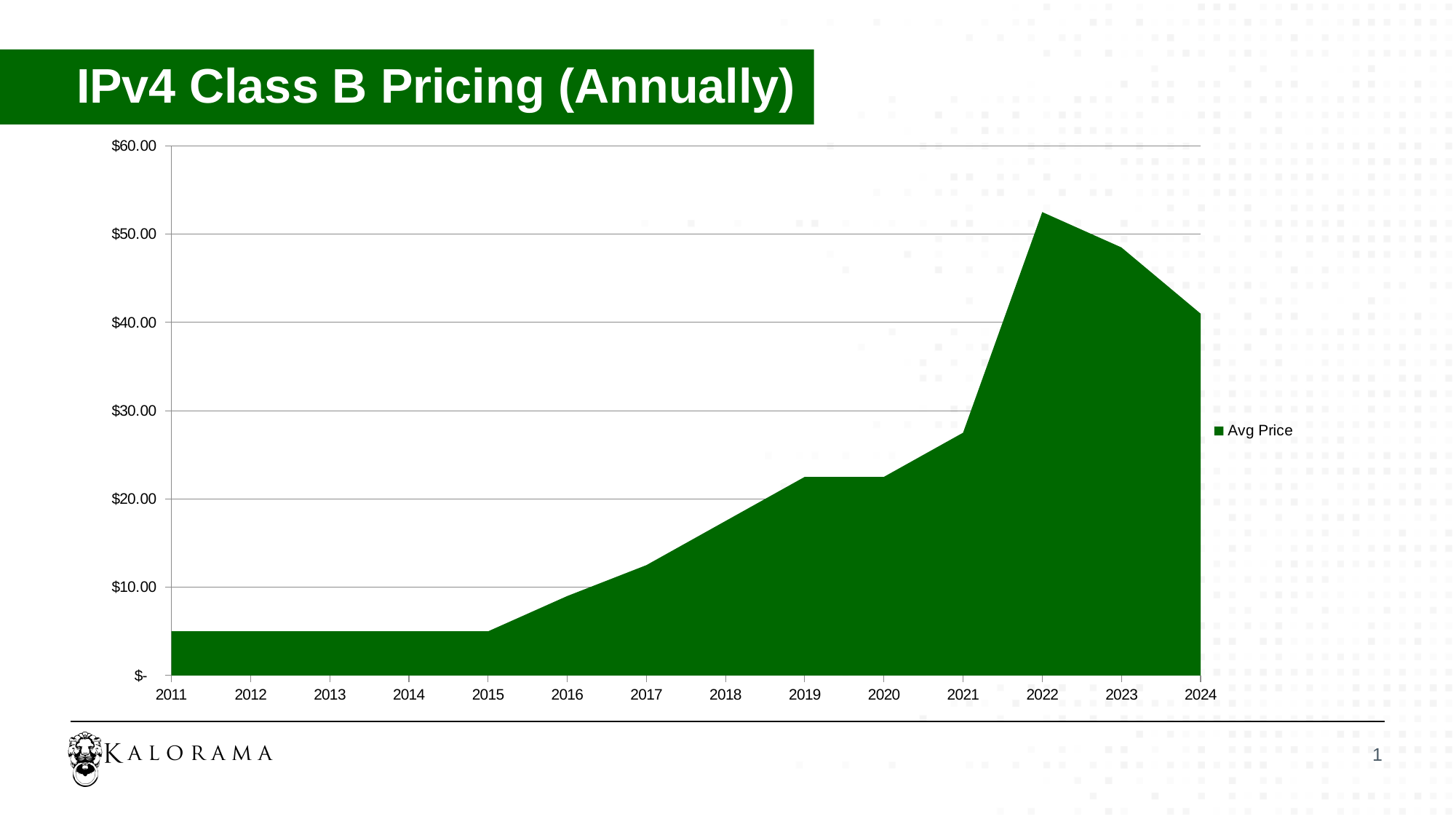
Is the value for 2016 greater or less than $10.00? less What is the title of the chart? IPv4 Class B Pricing (Annually) How many years are shown on the x axis? 14 Is the value for 2021 greater or less than $30.00? less Which year has the larger average price, 2022 or 2023? 2022 In which year is the average price highest? 2022 Is the value for 2022 greater or less than $50.00? greater How does the average price change from 2011 to 2022? It rises How many series does the legend list? 1 What is the name of the series shown in the legend? Avg Price What kind of chart is shown on the slide? Area chart